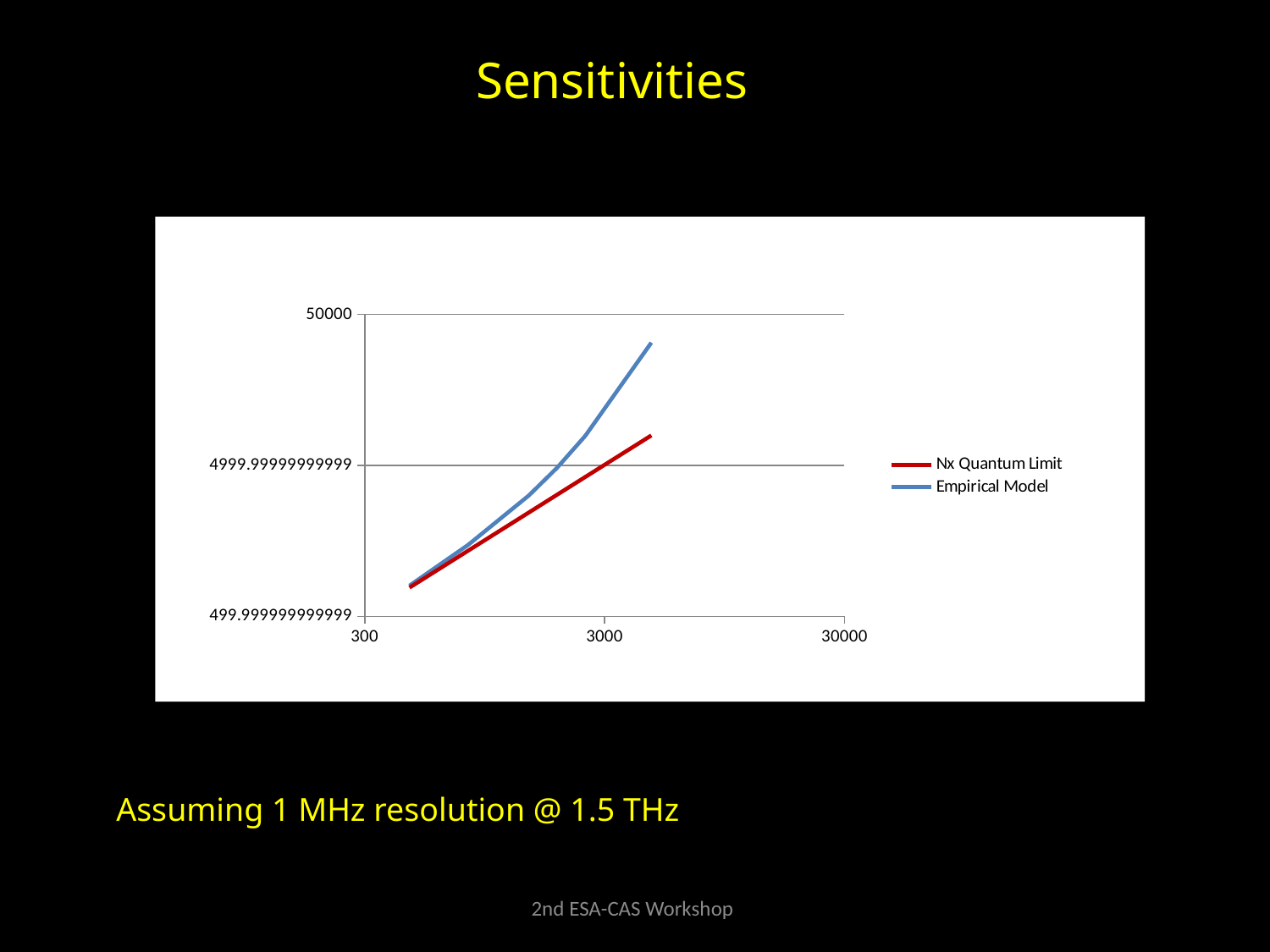
Do the values of the Nx Quantum Limit line rise or fall as the x axis increases? rise What is the largest tick value shown on the x axis? 30000 What kind of chart is shown on the slide? line chart How many series does the legend list? 2 Is the highest value of the Nx Quantum Limit line greater or less than 50000? less Is the highest value of the Empirical Model line greater or less than 50000? less What are the two series named in the legend? Nx Quantum Limit and Empirical Model At x = 3000, is the value of the Empirical Model line greater or less than 4999.99999999999? greater At the right-hand end of the lines, which series has the higher value, Nx Quantum Limit or Empirical Model? Empirical Model Do the values of the Empirical Model line rise or fall as the x axis increases? rise Which colour is used for the Empirical Model line? blue